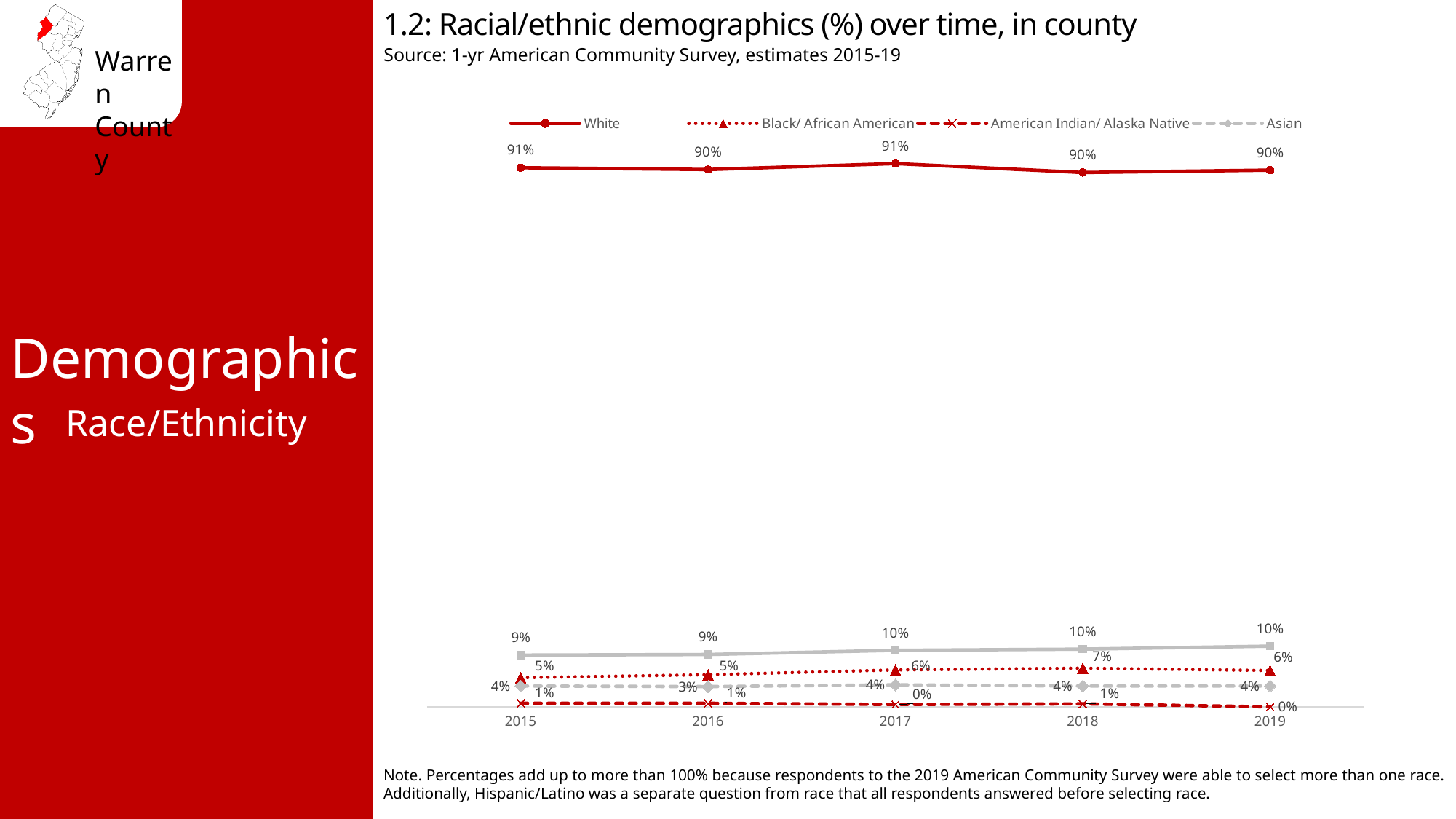
What is the value for American Indian/ Alaska Native in 2017? 0% What is the value for White in 2015? 91% In which year is the Black/ African American value highest? 2018 In which year is the Asian value lowest? 2016 What is the difference between the White value and the Asian value in 2015? 87 percentage points What is the value for Asian in 2016? 3% How many years are shown on the x axis? 5 Which is larger in 2019, the Black/ African American value or the Asian value? Black/ African American Does the Black/ African American value rise or fall from 2015 to 2018? rise What is the title of the chart? 1.2: Racial/ethnic demographics (%) over time, in county What is the value for Black/ African American in 2018? 7% What kind of chart is this? line chart